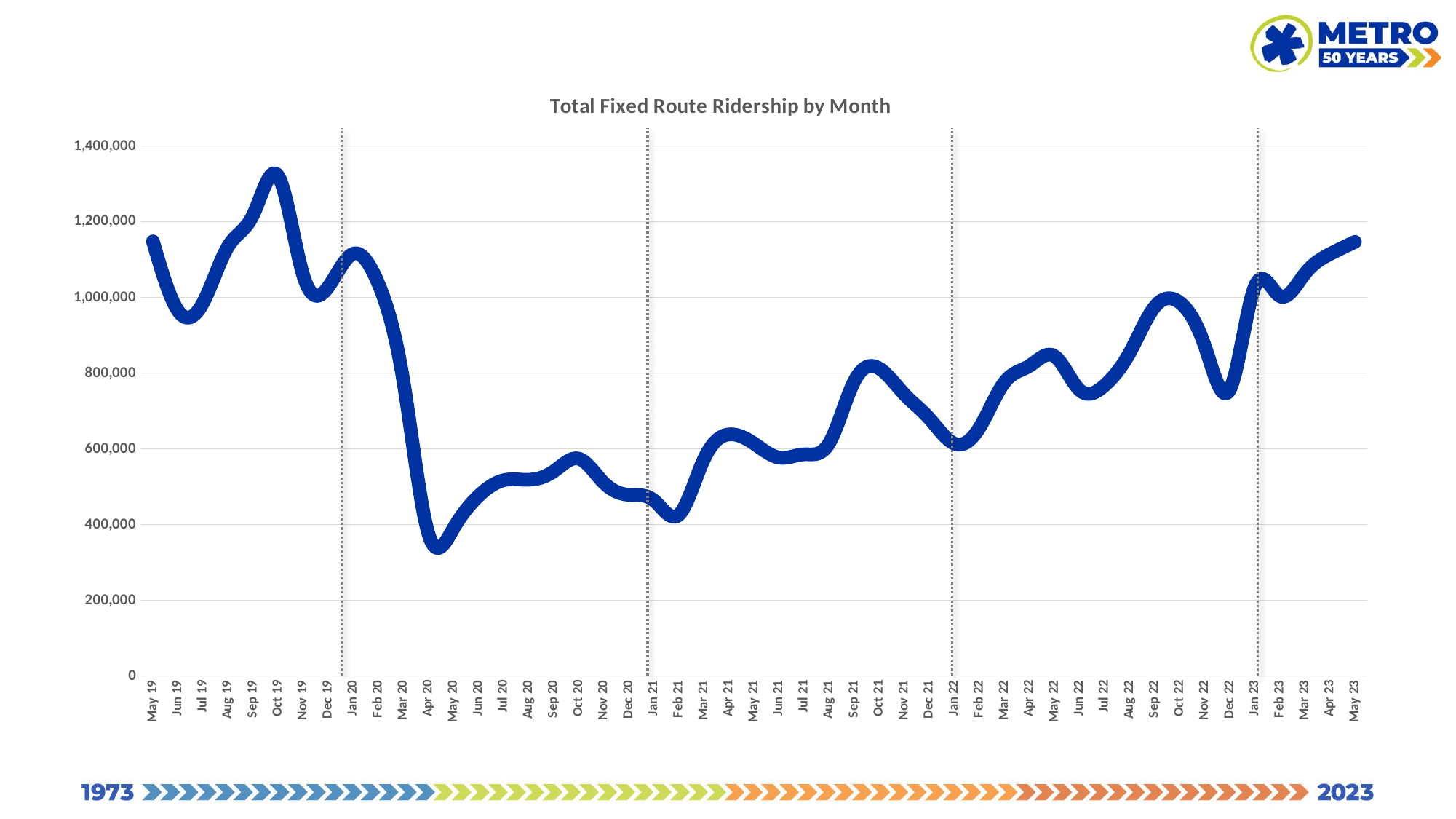
Is the value for May 23 greater or less than 1,000,000? greater Which month has the highest ridership on the chart? Oct 19 How many months are plotted on the x axis, from May 19 to May 23? 49 Does ridership rise or fall from Jan 20 to Apr 20? fall Which month has higher ridership, Jan 20 or Jan 21? Jan 20 What kind of chart is shown on the slide? line chart Is the value for Oct 19 greater or less than 1,200,000? greater What is the title of the chart? Total Fixed Route Ridership by Month Is the value for Dec 22 greater or less than 800,000? less Which month has the lowest ridership on the chart? Apr 20